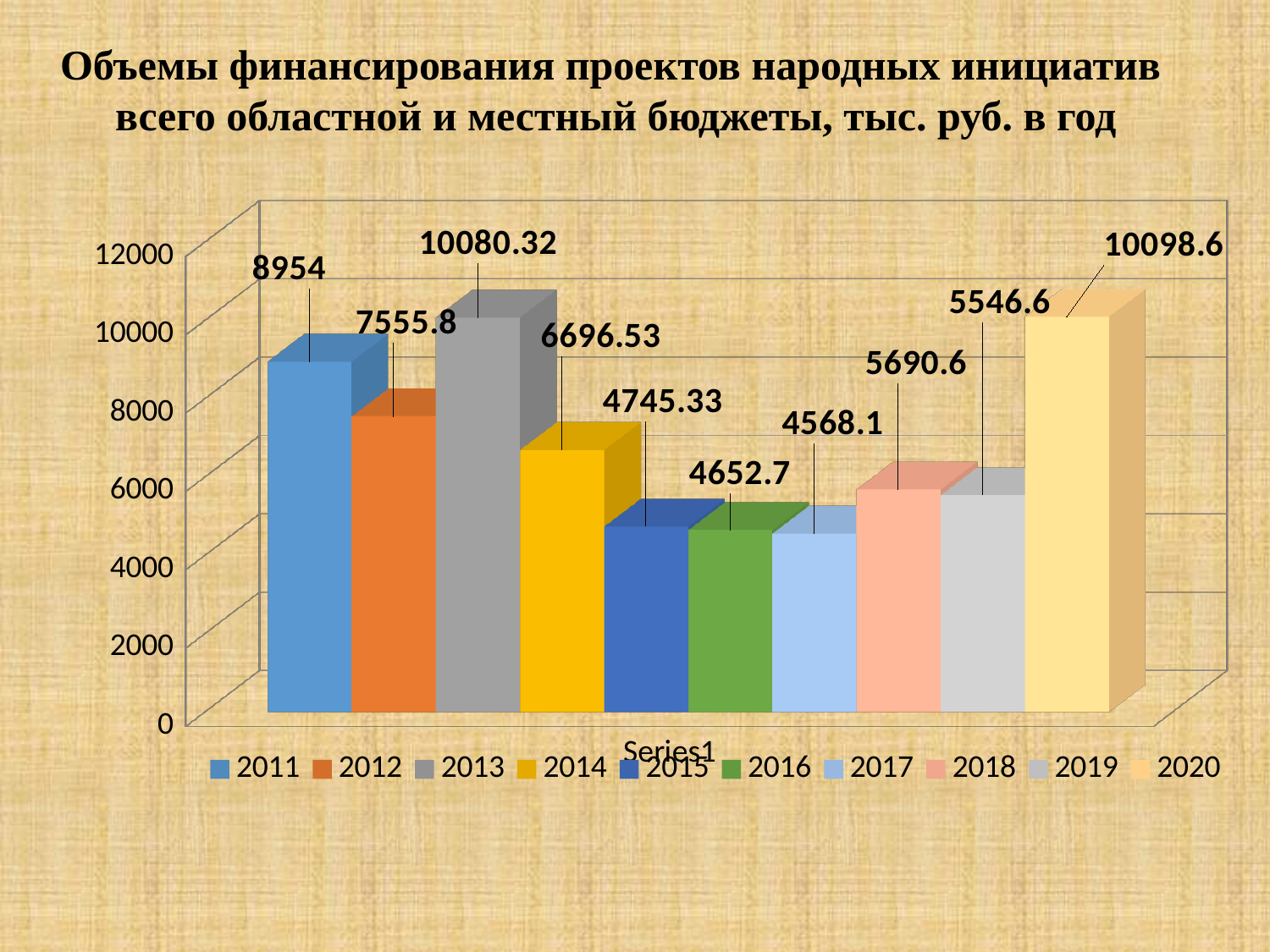
What is the value shown for 2017? 4568.1 Which is larger, the value for 2018 or the value for 2019? 2018 What is the value shown for 2013? 10080.32 Which year has the lowest value? 2017 How many entries does the legend list? 10 What is the difference between the values for 2011 and 2012? 1398.2 What is the difference between the values for 2020 and 2019? 4552 What colour is the bar for 2014? Yellow What kind of chart is shown on the slide? Bar chart What is the value shown for 2011? 8954 What is the value shown for 2020? 10098.6 Which year has the highest value? 2020